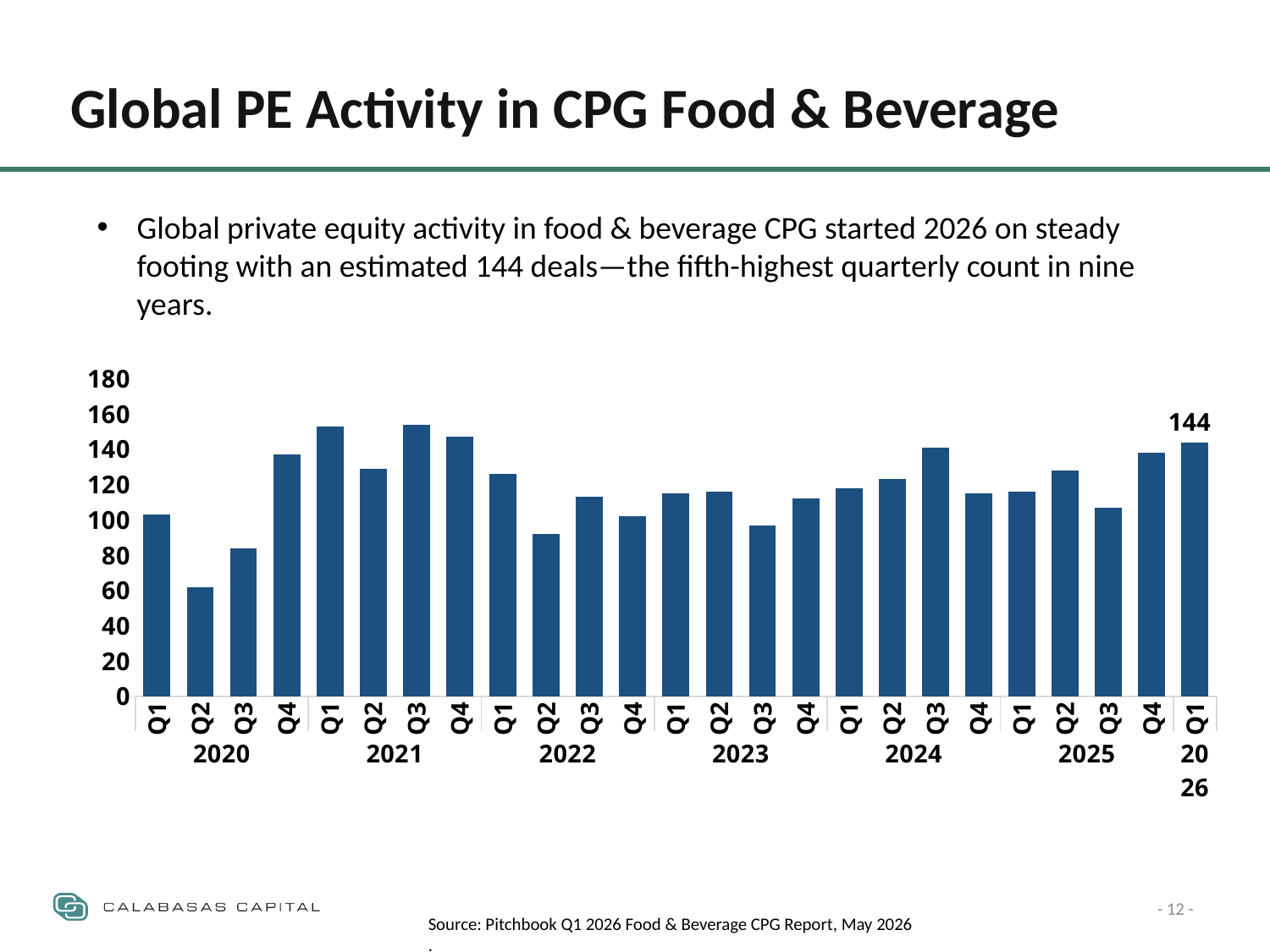
What is the title of the slide containing the chart? Global PE Activity in CPG Food & Beverage Is the value for Q3 2024 greater or less than 120? greater Which is larger, the value for Q2 2020 or the value for Q3 2020? Q3 2020 Is the value for Q1 2021 greater or less than 140? greater Which quarter has the lowest value? Q2 2020 Do the values rise or fall from Q3 2021 to Q2 2022? Fall Which is larger, the value for Q2 2022 or the value for Q1 2022? Q1 2022 Is the value for Q2 2020 greater or less than 80? less What is the value for Q1 2026? 144 How many quarterly bars are plotted in the chart? 25 What kind of chart is shown on the slide? Bar chart